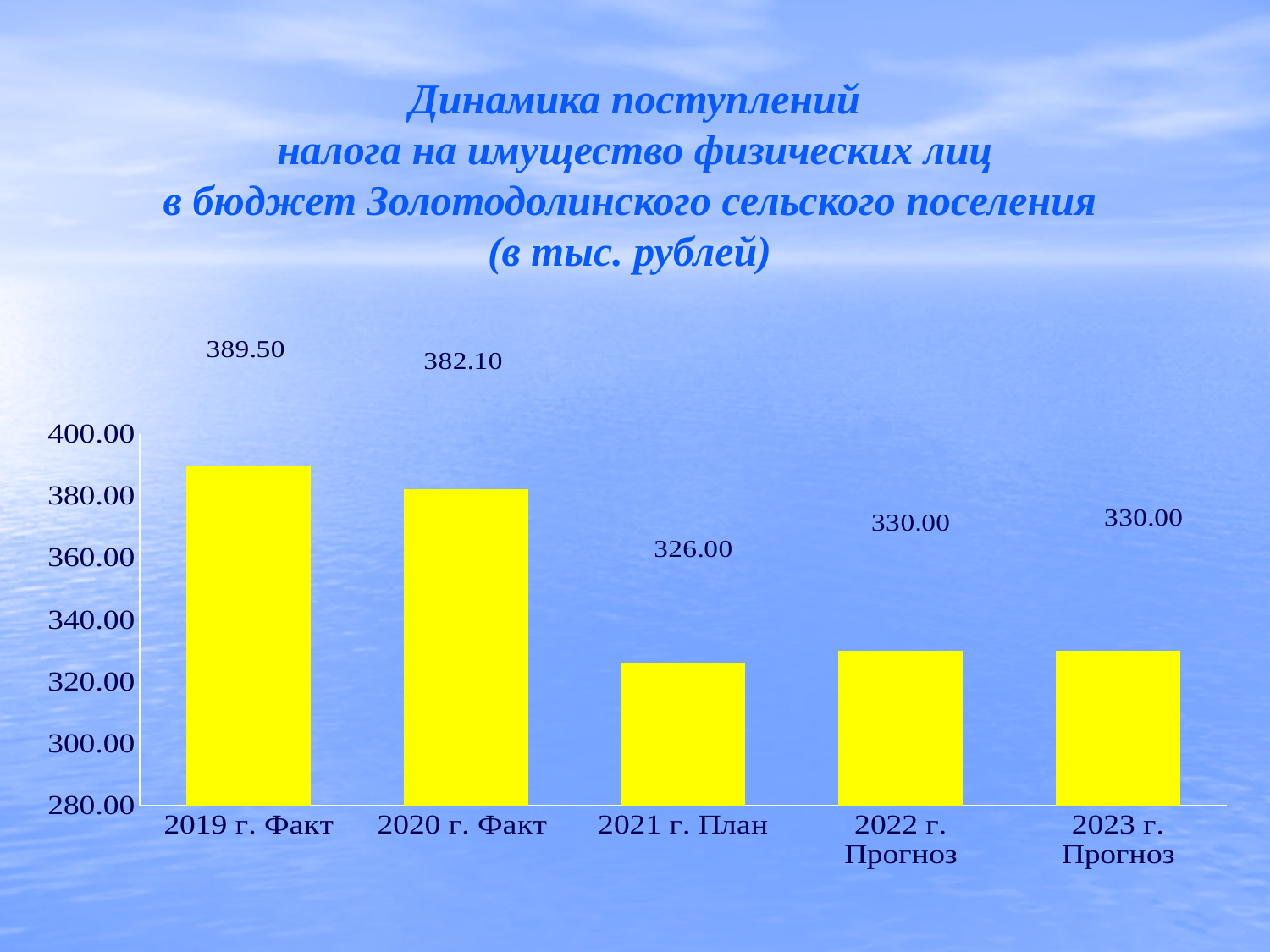
Is the value for 2021 г. План greater or less than 340.00? less What is the difference between the values for 2022 г. Прогноз and 2021 г. План? 4.00 Which is larger, the value for 2020 г. Факт or the value for 2022 г. Прогноз? 2020 г. Факт What colour are the bars in the chart? yellow What is the value for 2023 г. Прогноз? 330.00 What is the difference between the values for 2019 г. Факт and 2020 г. Факт? 7.40 What is the value for 2021 г. План? 326.00 Which category has the highest value? 2019 г. Факт What kind of chart is shown on the slide? bar chart Which category has the lowest value? 2021 г. План How many categories are shown on the x axis? 5 What is the value for 2019 г. Факт? 389.50